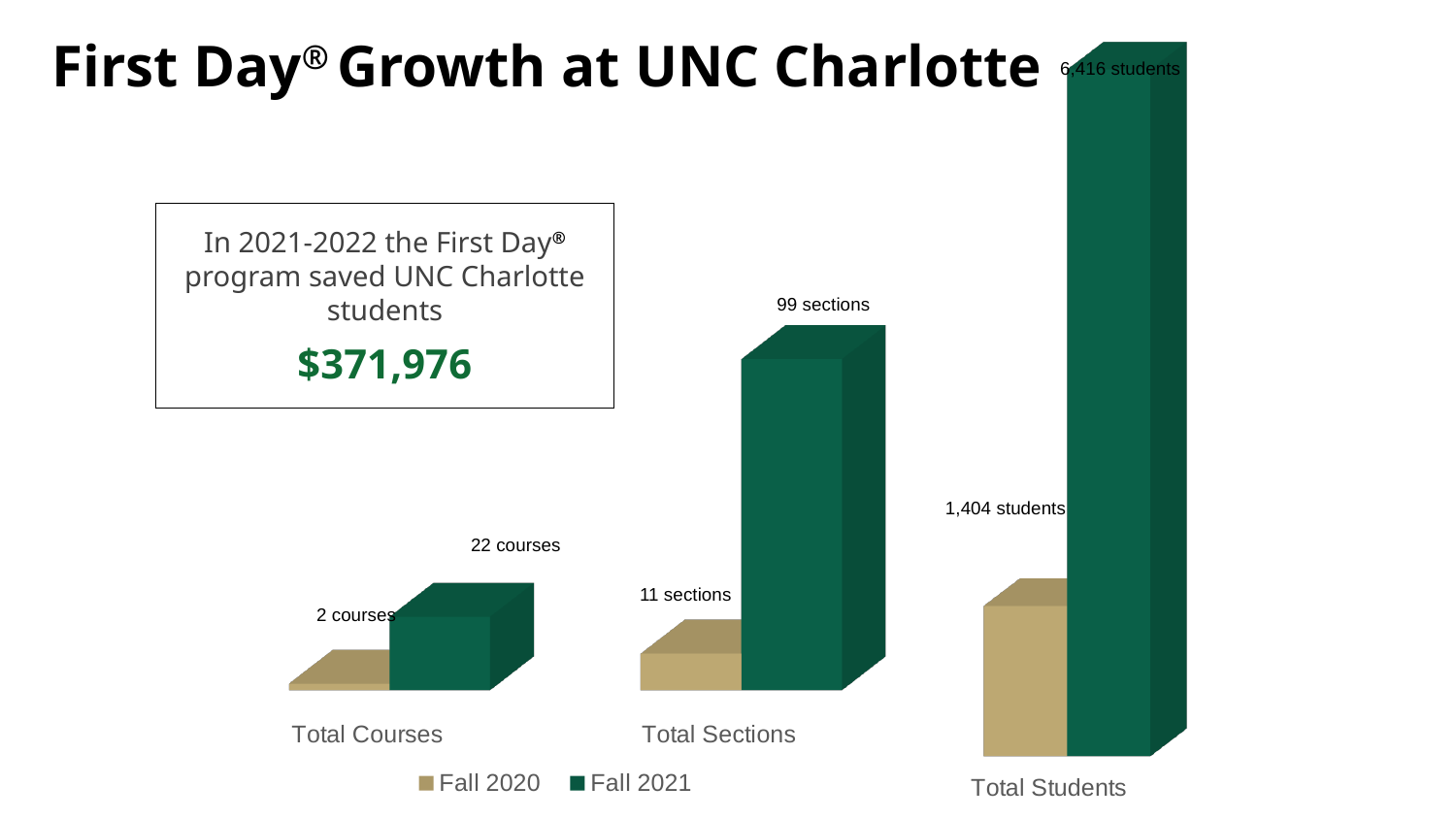
How many categories are shown on the x axis of the chart? 3 What kind of chart is shown on the slide? Bar chart How many series does the legend list? 2 What is the Fall 2020 value for Total Courses? 2 courses What is the Fall 2021 value for Total Students? 6,416 students What is the Fall 2020 value for Total Students? 1,404 students Which series has the larger value for Total Students, Fall 2020 or Fall 2021? Fall 2021 What is the Fall 2020 value for Total Sections? 11 sections What is the difference between the Fall 2021 and Fall 2020 values for Total Sections? 88 sections Which series is shown in green in the chart? Fall 2021 What is the Fall 2021 value for Total Courses? 22 courses What is the difference between the Fall 2021 and Fall 2020 values for Total Courses? 20 courses